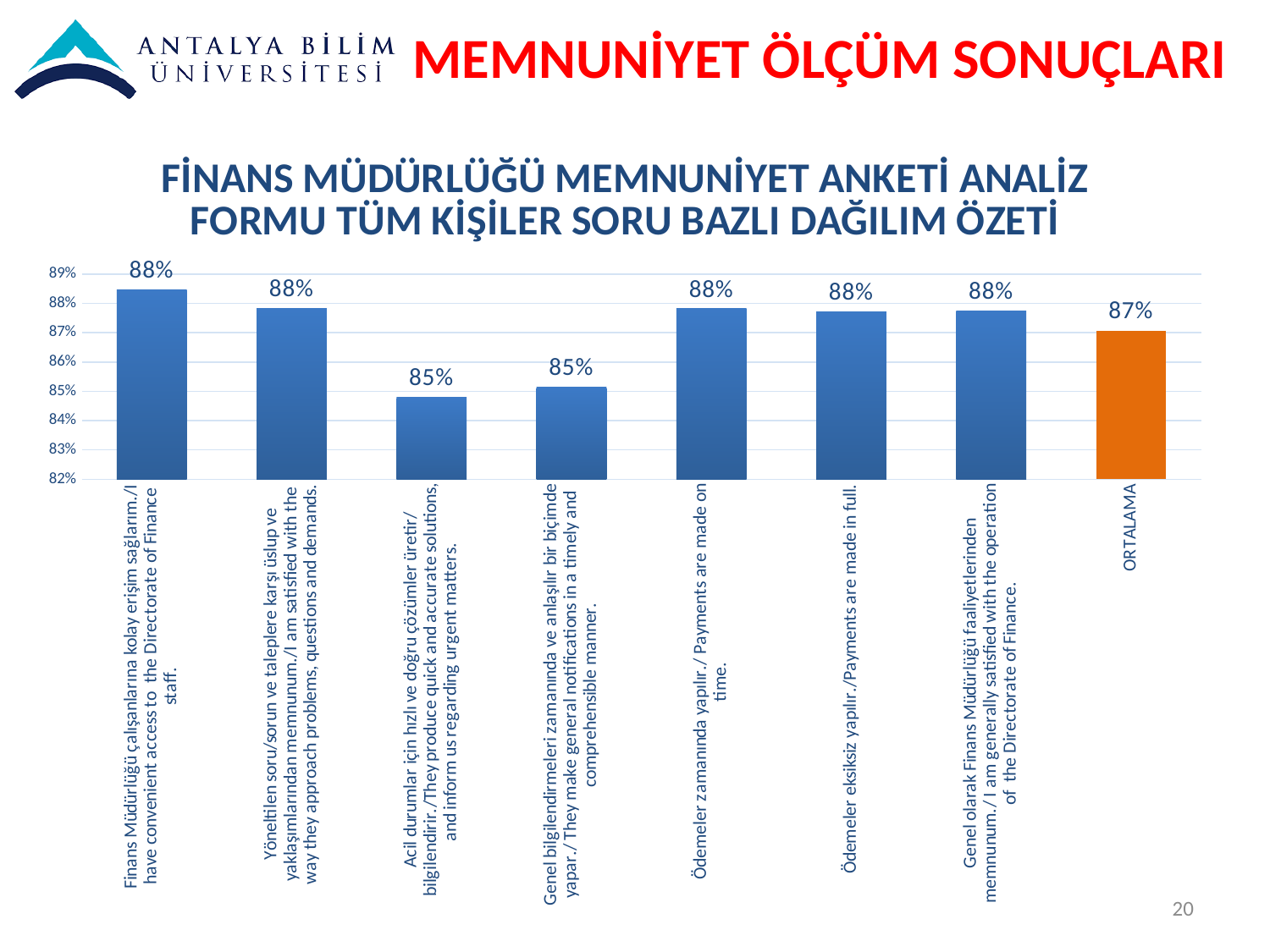
What kind of chart is shown on the slide? bar chart Which is larger: the value for "Payments are made on time" or the value for "They produce quick and accurate solutions, and inform us regarding urgent matters"? Payments are made on time How many bars are shown in the chart? 8 What is the value for "Ödemeler zamanında yapılır./Payments are made on time."? 88% Is the value for ORTALAMA greater or less than 86%? greater What colour is the ORTALAMA bar? orange What is the difference between the value for "Payments are made in full" and the value for "They make general notifications in a timely and comprehensible manner"? 3% Is the value for "They produce quick and accurate solutions, and inform us regarding urgent matters" greater or less than 87%? less What is the lowest value shown on the vertical axis? 82% What is the value for ORTALAMA? 87% What is the value for "Ödemeler eksiksiz yapılır./Payments are made in full."? 88% What is the value for "Acil durumlar için hızlı ve doğru çözümler üretir./They produce quick and accurate solutions, and inform us regarding urgent matters."? 85%